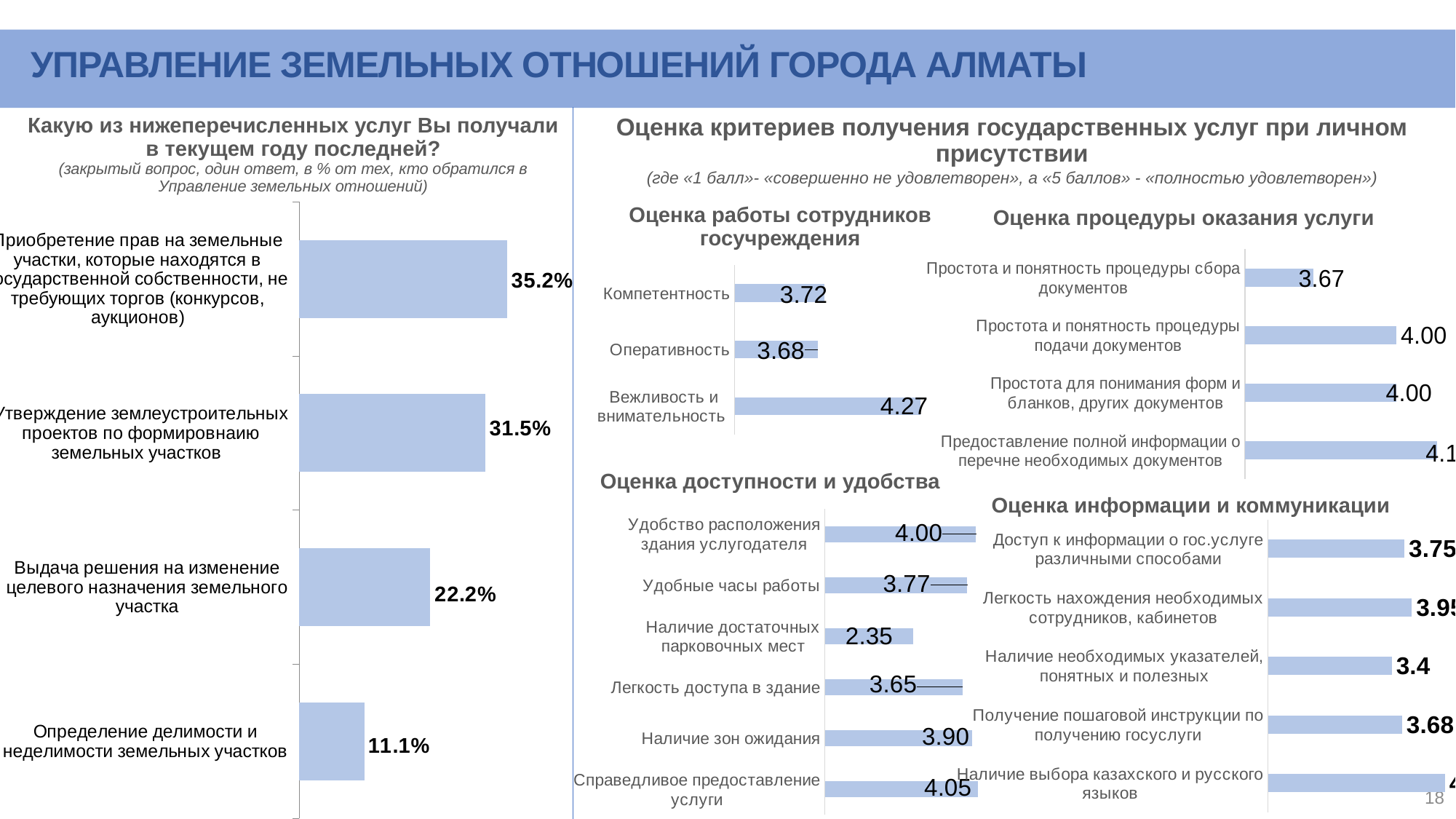
How many categories are shown in the chart "Какую из нижеперечисленных услуг Вы получали в текущем году последней?"? 4 In the chart "Оценка информации и коммуникации", which is larger: "Доступ к информации о гос.услуге различными способами" or "Наличие необходимых указателей, понятных и полезных"? Доступ к информации о гос.услуге различными способами What type of chart is "Оценка информации и коммуникации"? Bar chart In the chart "Оценка работы сотрудников госучреждения", what is the value for "Вежливость и внимательность"? 4.27 In the chart "Оценка доступности и удобства", what is the difference between "Справедливое предоставление услуги" and "Наличие достаточных парковочных мест"? 1.70 In the chart "Оценка работы сотрудников госучреждения", which category has the lowest value? Оперативность In the chart "Какую из нижеперечисленных услуг Вы получали в текущем году последней?", what is the difference between the highest value and the value for "Выдача решения на изменение целевого назначения земельного участка"? 13.0% In the chart "Оценка процедуры оказания услуги", what is the value for "Простота и понятность процедуры сбора документов"? 3.67 How many categories are shown in the chart "Оценка доступности и удобства"? 6 In the chart "Оценка доступности и удобства", which category has the lowest value? Наличие достаточных парковочных мест In the chart "Какую из нижеперечисленных услуг Вы получали в текущем году последней?", what is the value for "Утверждение землеустроительных проектов по формировнаию земельных участков"? 31.5% In the chart "Какую из нижеперечисленных услуг Вы получали в текущем году последней?", which category has the lowest value? Определение делимости и неделимости земельных участков